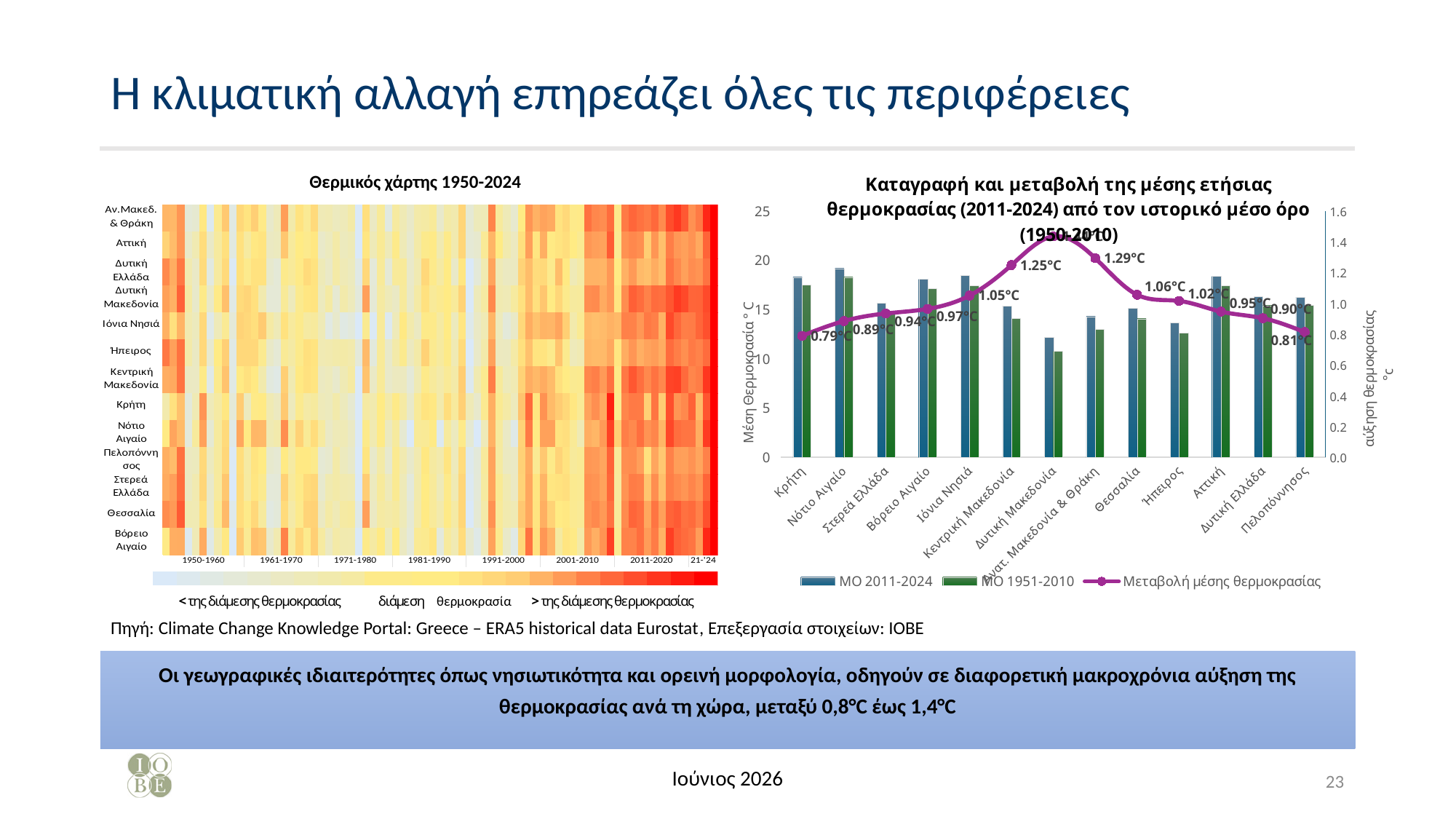
How many regions are shown on the x axis of the right chart? 13 On the right chart, which region has the highest value on the Μεταβολή μέσης θερμοκρασίας line? Δυτική Μακεδονία On the right chart, which has a larger Μεταβολή μέσης θερμοκρασίας value, Κεντρική Μακεδονία or Θεσσαλία? Κεντρική Μακεδονία On the right chart, which region has the lowest value on the Μεταβολή μέσης θερμοκρασίας line? Κρήτη On the right chart, what is the value of the Μεταβολή μέσης θερμοκρασίας line for Θεσσαλία? 1.06°C What is the title of the left chart? Θερμικός χάρτης 1950-2024 On the right chart, is the ΜΟ 2011-2024 value for Δυτική Μακεδονία greater or less than 15? less On the right chart, what is the value of the Μεταβολή μέσης θερμοκρασίας line for Κρήτη? 0.79°C On the right chart, what is the value of the Μεταβολή μέσης θερμοκρασίας line for Ανατ. Μακεδονία & Θράκη? 1.29°C How many series does the legend of the right chart list? 3 On the right chart, which region has the lowest ΜΟ 2011-2024 bar? Δυτική Μακεδονία On the right chart, what is the difference between the Μεταβολή μέσης θερμοκρασίας values for Ανατ. Μακεδονία & Θράκη and Κρήτη? 0.50°C